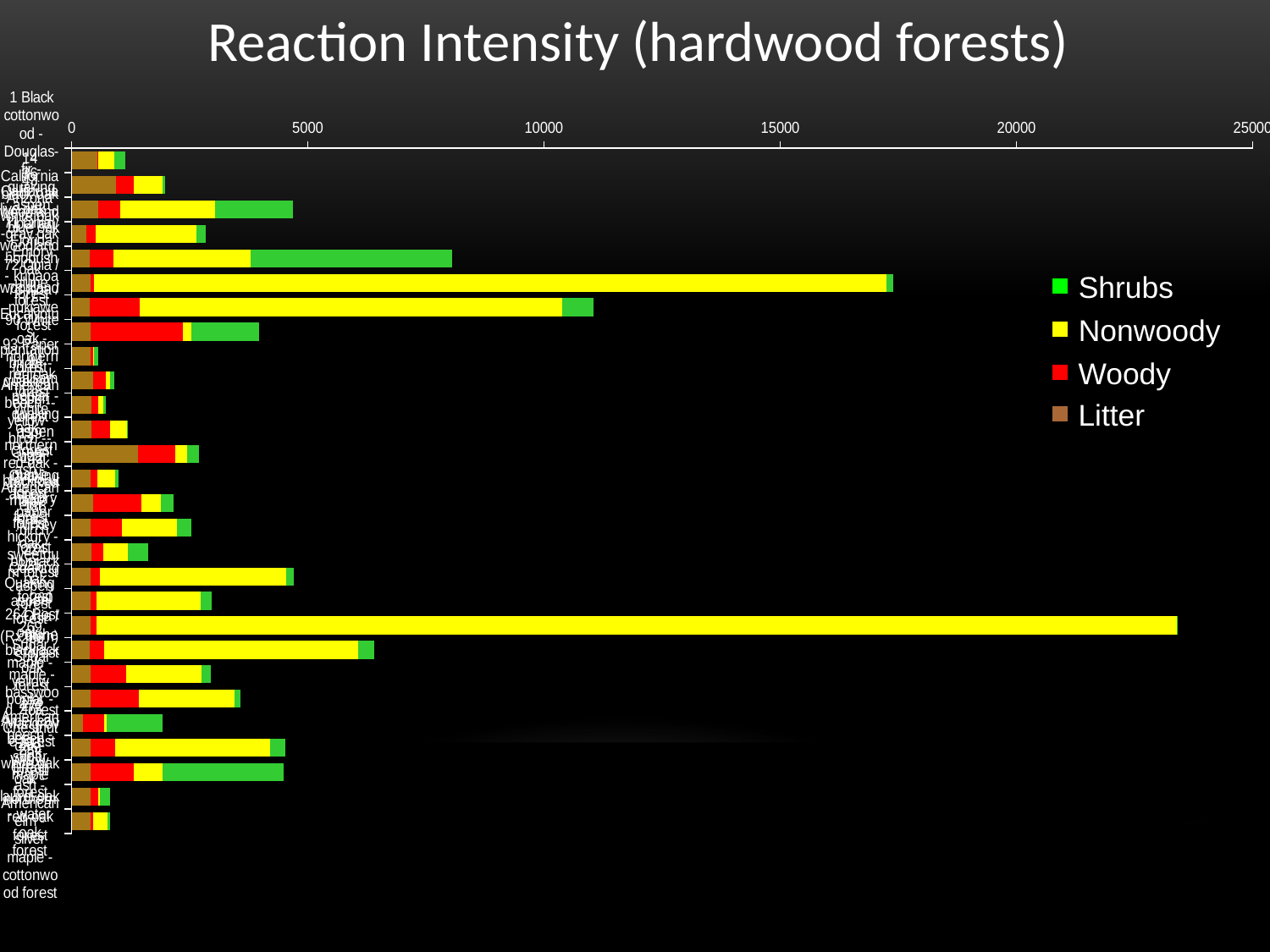
How many bars (categories) are plotted in the chart? 28 Which colour represents the Litter series? Brown What is the title of the chart? Reaction Intensity (hardwood forests) Is the total of the second-longest bar greater or less than 15000? greater What are the series names listed in the legend? Shrubs, Nonwoody, Woody, Litter Which series makes up most of the longest bar? Nonwoody Is the total of the topmost bar greater or less than 5000? less Is the total of the bottommost bar greater or less than 5000? less How many series does the legend list? 4 What type of chart is shown on the slide? Stacked bar chart What is the highest value shown on the horizontal axis? 25000